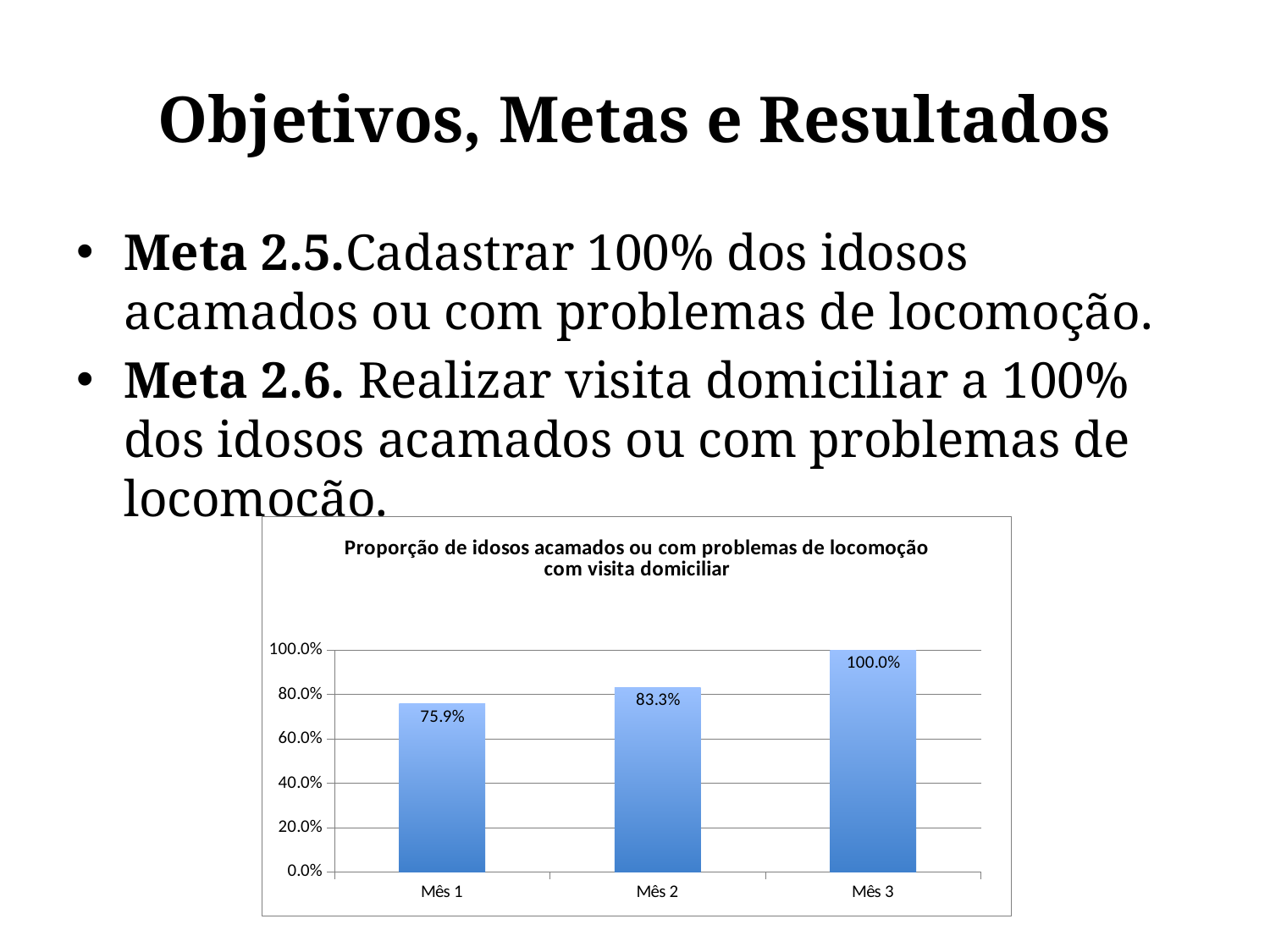
What is the difference between the values for Mês 2 and Mês 1? 7.4% Do the values rise or fall from Mês 1 to Mês 3? rise Is the value for Mês 1 greater or less than 80.0%? less How many months are shown on the x axis? 3 What is the value for Mês 1? 75.9% Which month has the lowest value? Mês 1 What is the value for Mês 2? 83.3% What is the difference between the values for Mês 3 and Mês 1? 24.1% What kind of chart is shown on the slide? bar chart What is the value for Mês 3? 100.0% Which is larger, the value for Mês 2 or the value for Mês 1? Mês 2 Which month has the highest value? Mês 3